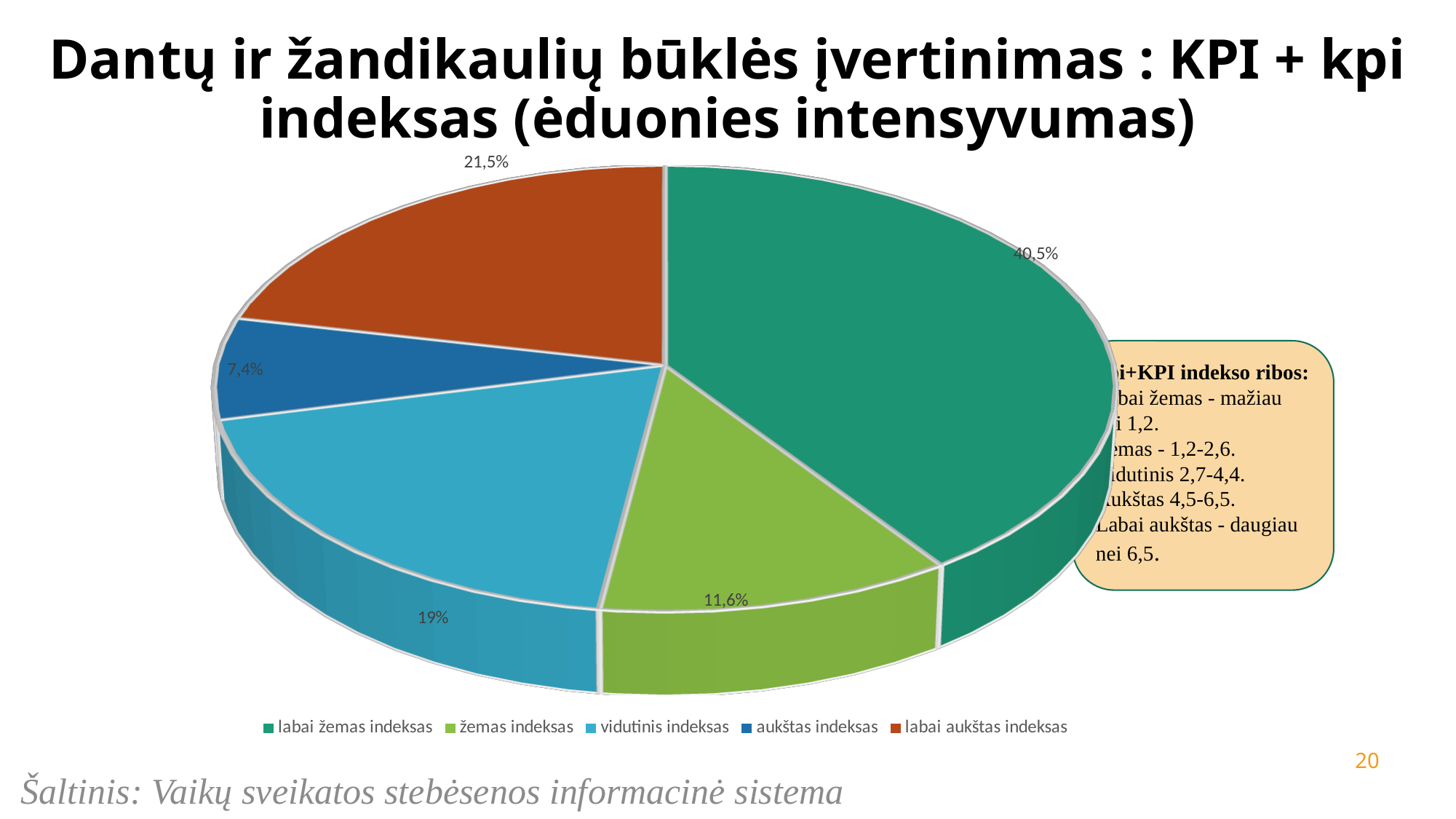
Which category has the largest slice of the pie? labai žemas indeksas Which is larger: the slice for "vidutinis indeksas" or the slice for "labai aukštas indeksas"? labai aukštas indeksas What kind of chart is shown on the slide? pie chart What is the difference in percentage points between the "labai žemas indeksas" slice and the "labai aukštas indeksas" slice? 19 percentage points What share of the pie is labelled "labai aukštas indeksas"? 21,5% What share of the pie is labelled "aukštas indeksas"? 7,4% What share of the pie is labelled "žemas indeksas"? 11,6% What colour is the slice for "aukštas indeksas"? dark blue What share of the pie is labelled "vidutinis indeksas"? 19% Which category has the smallest slice of the pie? aukštas indeksas What share of the pie is labelled "labai žemas indeksas"? 40,5% How many slices does the pie chart have? 5